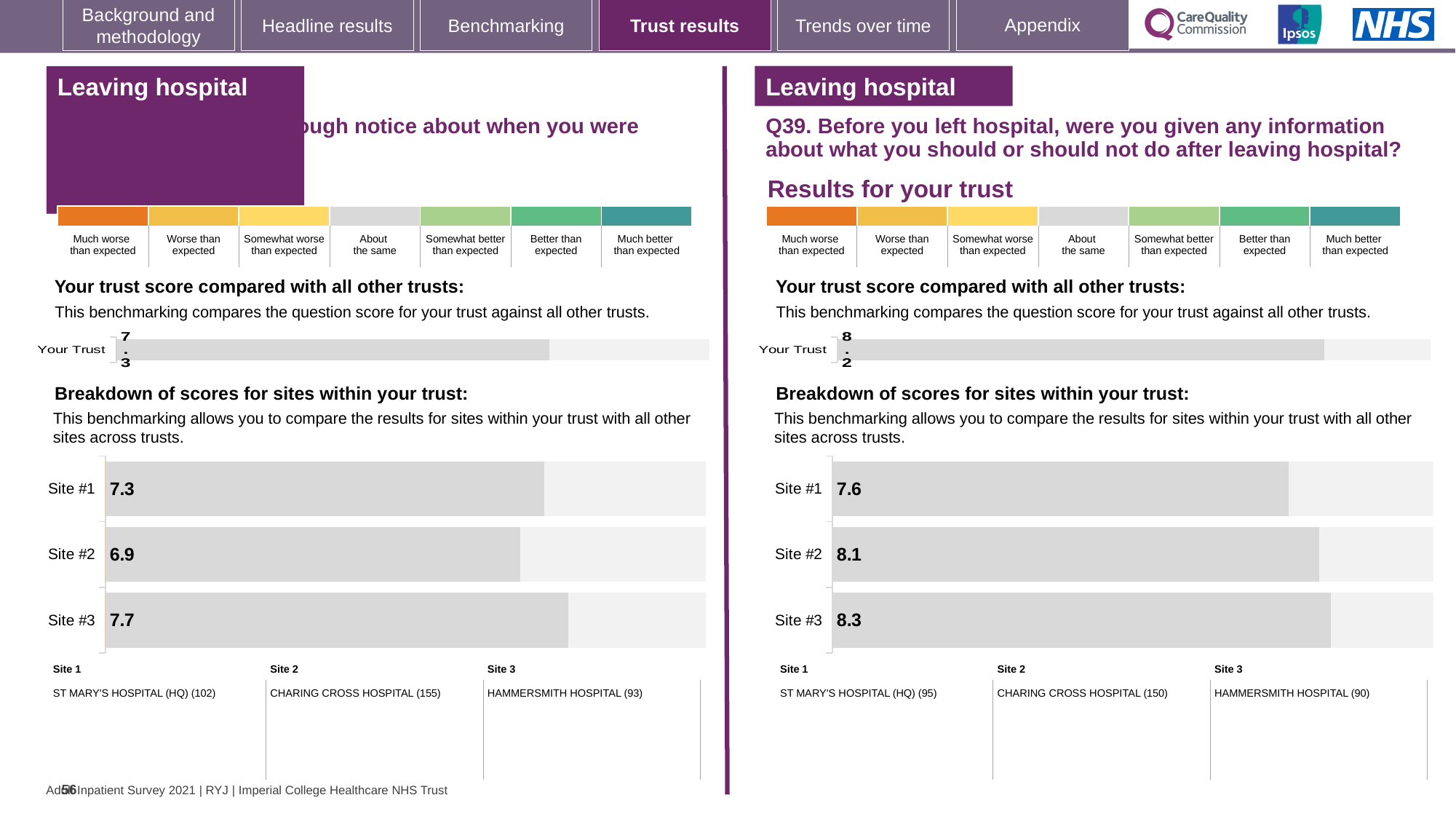
On the left-hand site breakdown chart, which site has the lowest score? Site #2 On the right-hand (Q39) site breakdown chart, what is the difference between the scores for Site #3 and Site #1? 0.7 On the left-hand site breakdown chart, which site has the highest score? Site #3 On the left-hand site breakdown chart, what is the score for Site #1? 7.3 How many sites are shown on the right-hand (Q39) site breakdown chart? 3 On the left-hand site breakdown chart, which has the higher score, Site #1 or Site #2? Site #1 On the right-hand (Q39) 'Your trust score compared with all other trusts' chart, what is the score for Your Trust? 8.2 On the right-hand (Q39) site breakdown chart, what is the score for Site #2? 8.1 On the left-hand 'Your trust score compared with all other trusts' chart, what is the score for Your Trust? 7.3 On the right-hand (Q39) site breakdown chart, which site has the lowest score? Site #1 On the left-hand site breakdown chart, what is the difference between the scores for Site #3 and Site #2? 0.8 What type of chart is used for the site breakdown on the left-hand side of the slide? Bar chart